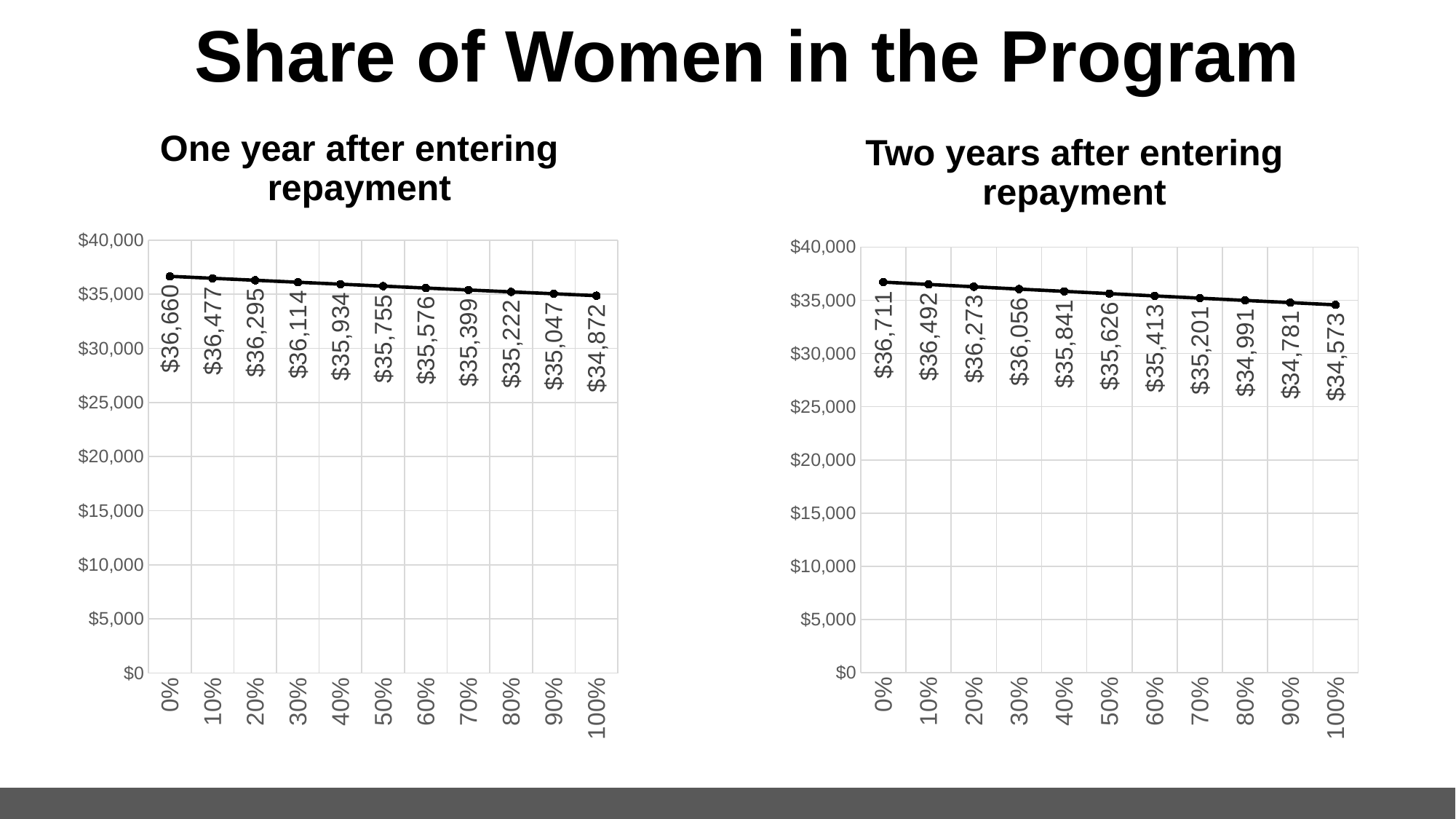
In the 'One year after entering repayment' chart, how many data points are plotted? 11 In the 'One year after entering repayment' chart, what is the value at 0%? $36,660 In the 'One year after entering repayment' chart, do the values rise or fall as the share of women increases from 0% to 100%? Fall What kind of chart is the 'Two years after entering repayment' chart? Line chart Which is larger: the value at 0% in the 'One year after entering repayment' chart or the value at 0% in the 'Two years after entering repayment' chart? Two years after entering repayment In the 'Two years after entering repayment' chart, what is the value at 100%? $34,573 In the 'One year after entering repayment' chart, what is the difference between the values at 0% and 100%? $1,788 In the 'One year after entering repayment' chart, which share of women has the highest value? 0% In the 'Two years after entering repayment' chart, what is the value at 40%? $35,841 In the 'One year after entering repayment' chart, what is the value at 50%? $35,755 In the 'Two years after entering repayment' chart, which share of women has the lowest value? 100% In the 'Two years after entering repayment' chart, what is the difference between the values at 0% and 100%? $2,138